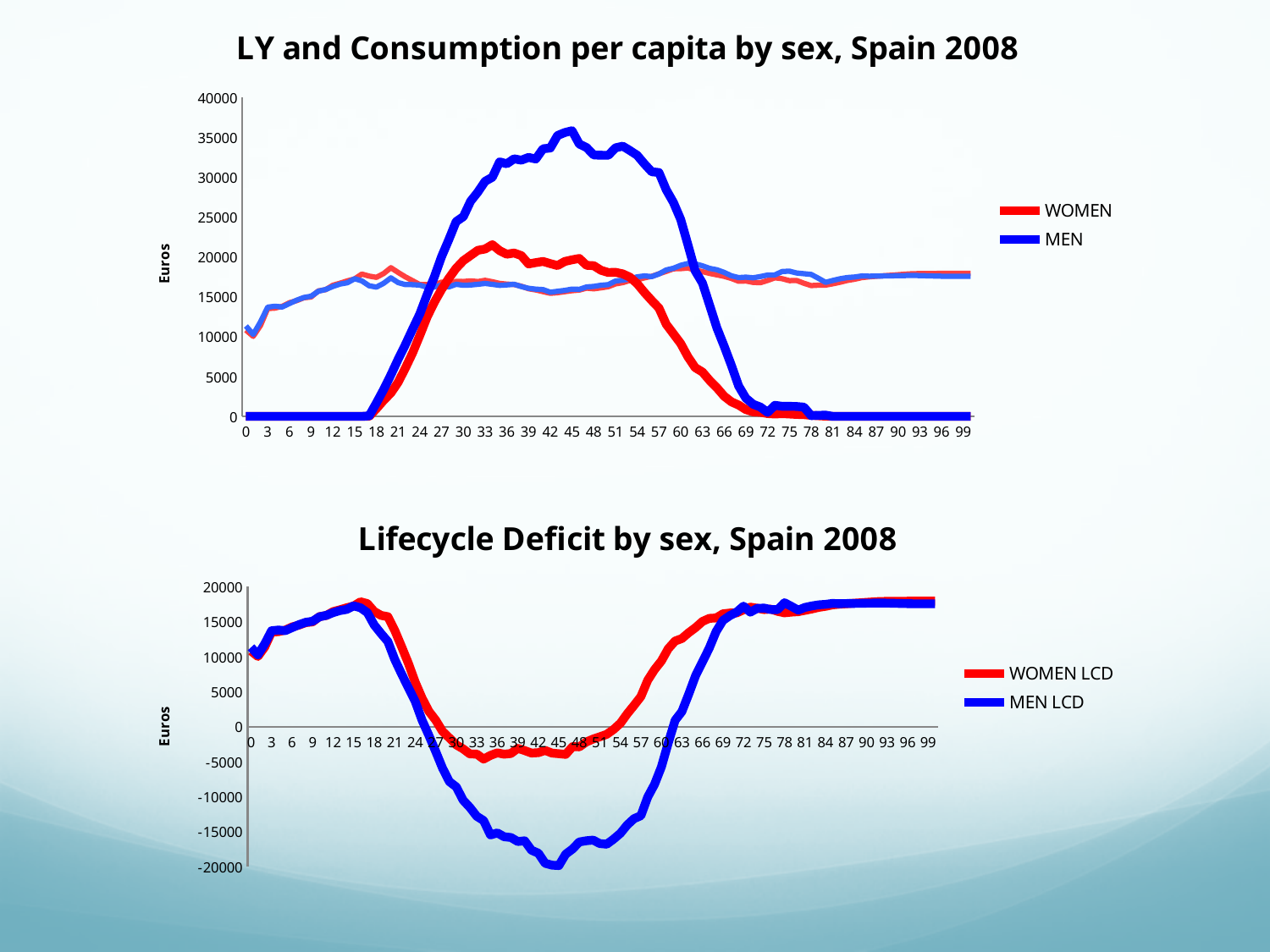
In the top chart, is the peak value of the thick MEN line greater or less than 30000? greater In the bottom chart, do the MEN LCD values rise or fall between age 18 and age 45? fall In the top chart, is the peak value of the thick WOMEN line greater or less than 25000? less In the bottom chart, what are the two legend entries? WOMEN LCD and MEN LCD In the top chart, how many series does the legend list? 2 In the bottom chart, is the lowest value of the WOMEN LCD line greater or less than -10000? greater What kind of chart is the bottom chart, 'Lifecycle Deficit by sex, Spain 2008'? Line chart What kind of chart is the top chart, 'LY and Consumption per capita by sex, Spain 2008'? Line chart In the top chart, at age 45, which thick line is higher, MEN or WOMEN? MEN In the bottom chart, at age 45, which line is higher, WOMEN LCD or MEN LCD? WOMEN LCD In the top chart, what is the label on the vertical axis? Euros